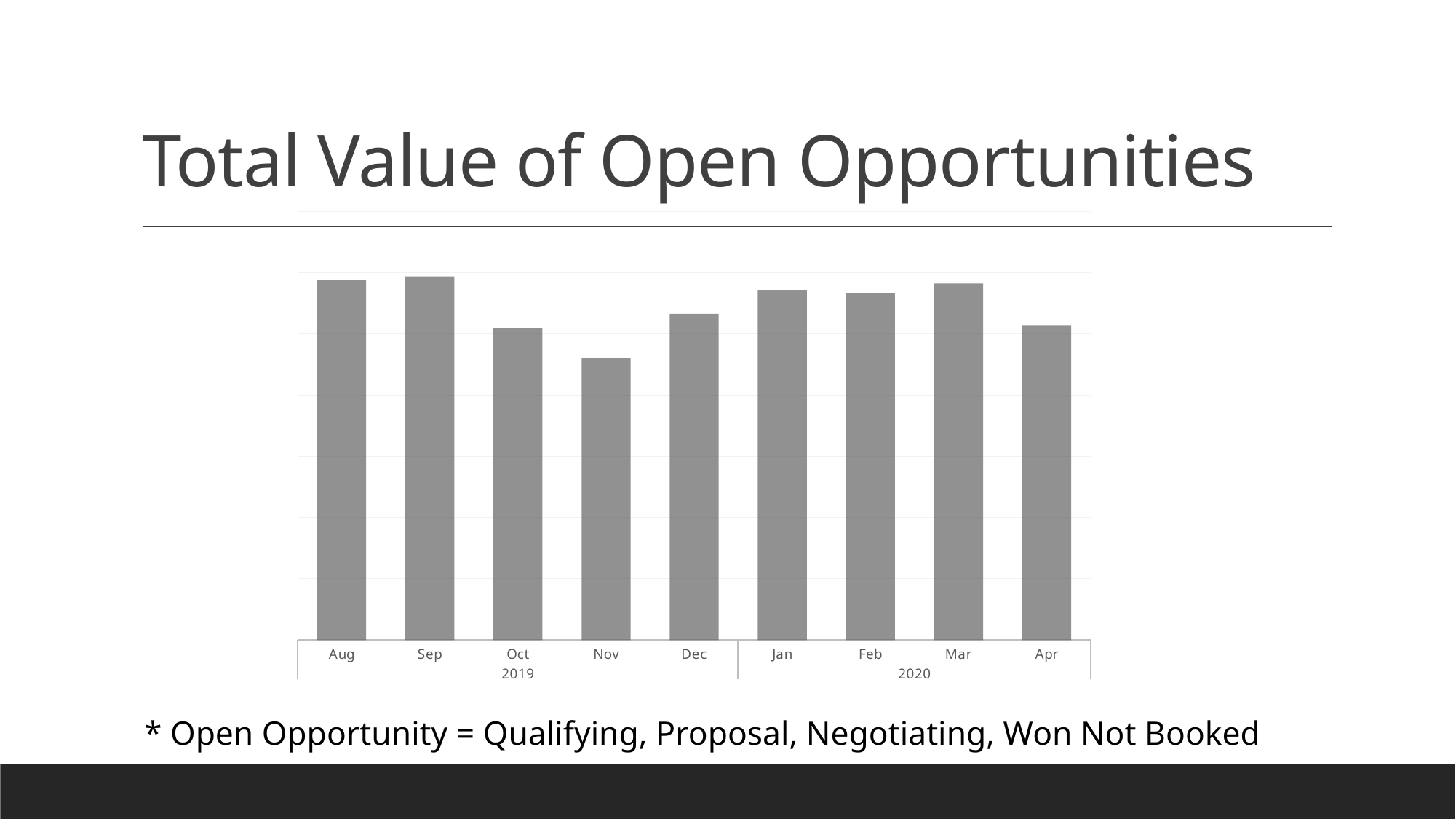
Which is larger, the value for Aug or the value for Apr? Aug Which month has the lowest total value of open opportunities? Nov Do the values rise or fall from Sep to Nov? fall Which two years are labelled on the x axis of the chart? 2019 and 2020 What is the title of the chart on the slide? Total Value of Open Opportunities Which is larger, the value for Dec or the value for Nov? Dec Which is larger, the value for Mar or the value for Apr? Mar Do the values rise or fall from Nov to Jan? rise What kind of chart is shown on the slide? bar chart How many months are plotted in the chart? 9